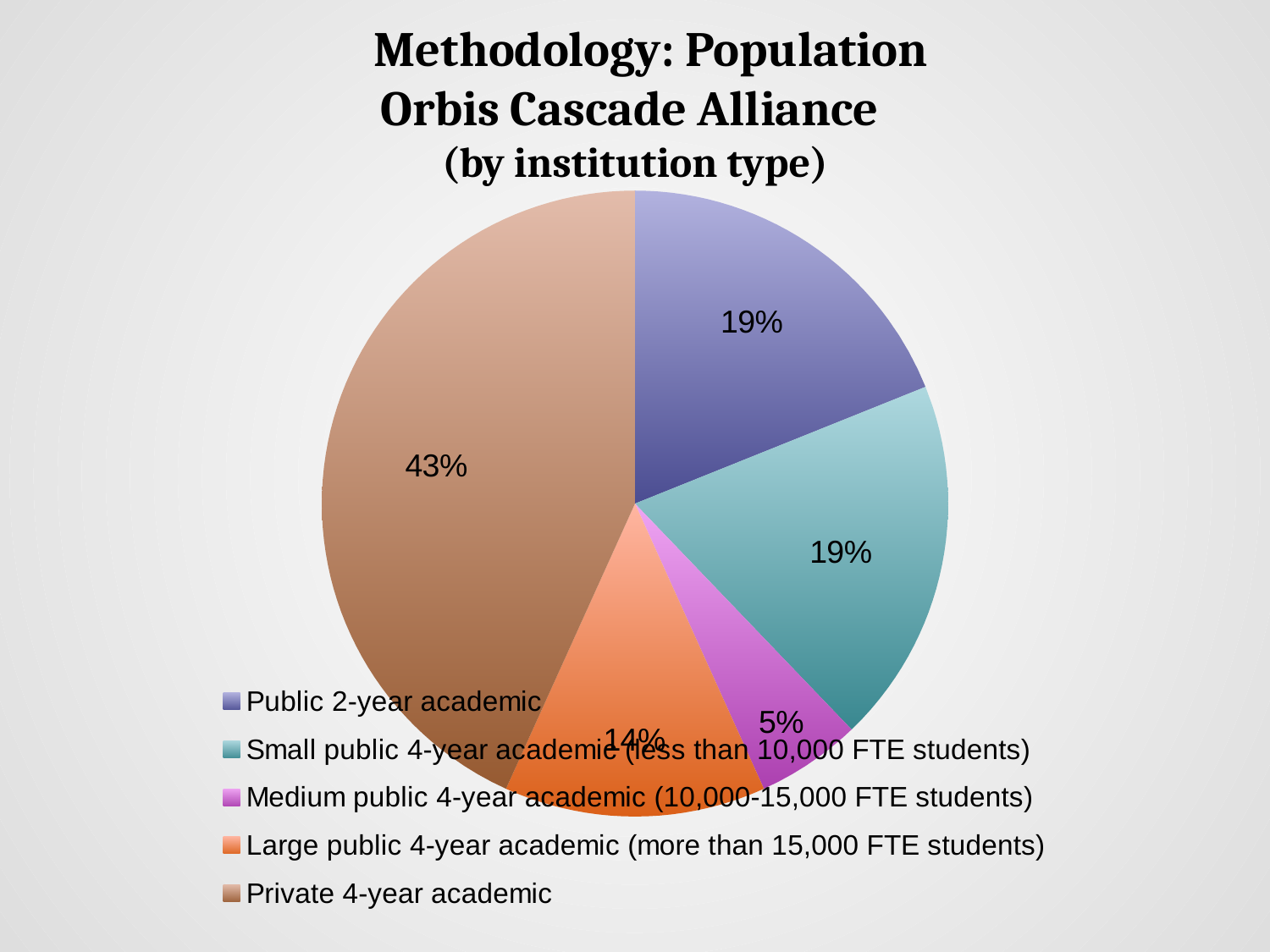
What share of the pie is Public 2-year academic? 19% What kind of chart is shown on the slide? pie chart Which institution type has the largest slice of the pie? Private 4-year academic Which institution type has the smallest slice of the pie? Medium public 4-year academic (10,000-15,000 FTE students) What share of the pie is Large public 4-year academic (more than 15,000 FTE students)? 14% Which is larger: the Large public 4-year academic slice or the Medium public 4-year academic slice? Large public 4-year academic What is the title of the chart? Methodology: Population Orbis Cascade Alliance (by institution type) What share of the pie is Medium public 4-year academic (10,000-15,000 FTE students)? 5% What is the difference in percentage points between the Private 4-year academic slice and the Large public 4-year academic slice? 29 How many institution types are shown in the pie chart? 5